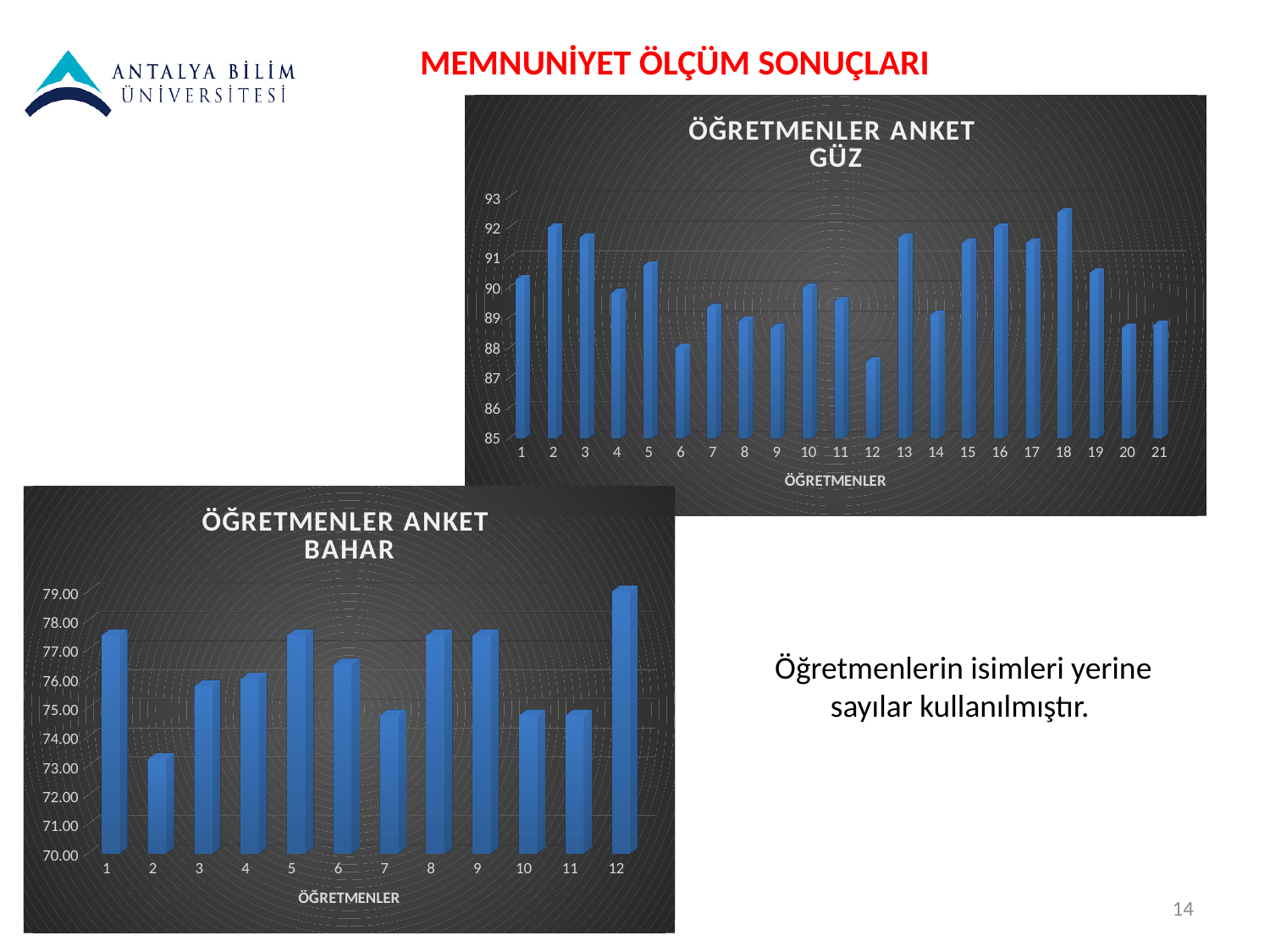
In the ÖĞRETMENLER ANKET BAHAR chart, is the value for teacher 2 greater or less than 74.00? less In the ÖĞRETMENLER ANKET GÜZ chart, is the value for teacher 18 greater or less than 92? greater In the ÖĞRETMENLER ANKET BAHAR chart, which teacher number has the lowest value? 2 In the ÖĞRETMENLER ANKET GÜZ chart, which has the larger value, teacher 1 or teacher 12? Teacher 1 What type of chart is the ÖĞRETMENLER ANKET BAHAR chart? Bar chart In the ÖĞRETMENLER ANKET GÜZ chart, is the value for teacher 12 greater or less than 88? less In the ÖĞRETMENLER ANKET GÜZ chart, how many teachers are shown on the x axis? 21 In the ÖĞRETMENLER ANKET GÜZ chart, which teacher number has the highest value? 18 In the ÖĞRETMENLER ANKET GÜZ chart, which teacher number has the lowest value? 12 In the ÖĞRETMENLER ANKET BAHAR chart, which teacher number has the highest value? 12 In the ÖĞRETMENLER ANKET BAHAR chart, how many teachers are shown on the x axis? 12